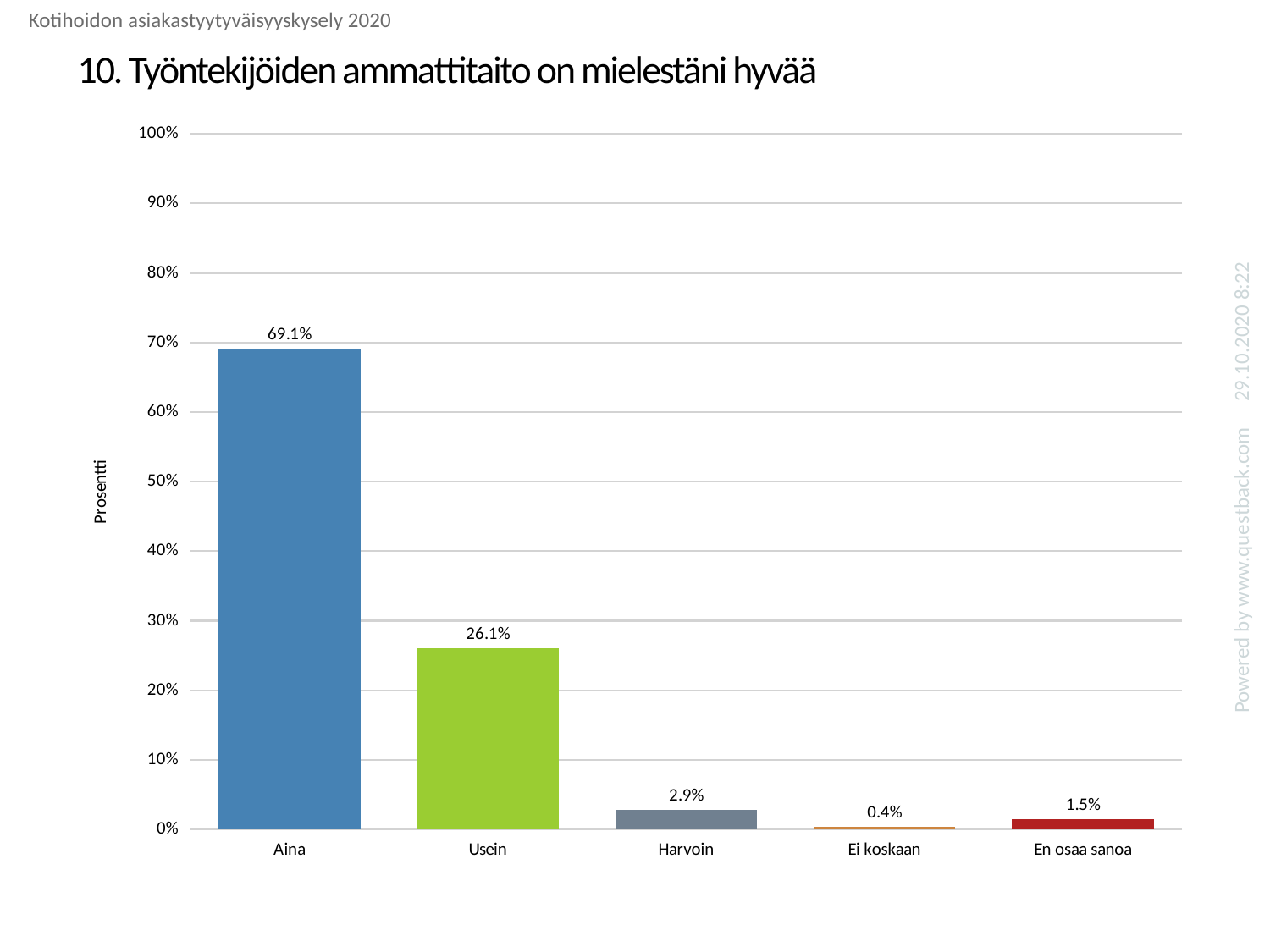
What kind of chart is shown on the slide? bar chart How many categories are shown on the x axis? 5 What is the value for Usein? 26.1% What is the value for En osaa sanoa? 1.5% What is the difference between the values for Aina and Usein? 43.0% Is the value for Usein greater or less than 30%? less What is the value for Harvoin? 2.9% What is the value for Aina? 69.1% Which category has the highest value? Aina Which is larger, the value for Harvoin or the value for En osaa sanoa? Harvoin What is the label of the y axis? Prosentti Which category has the lowest value? Ei koskaan